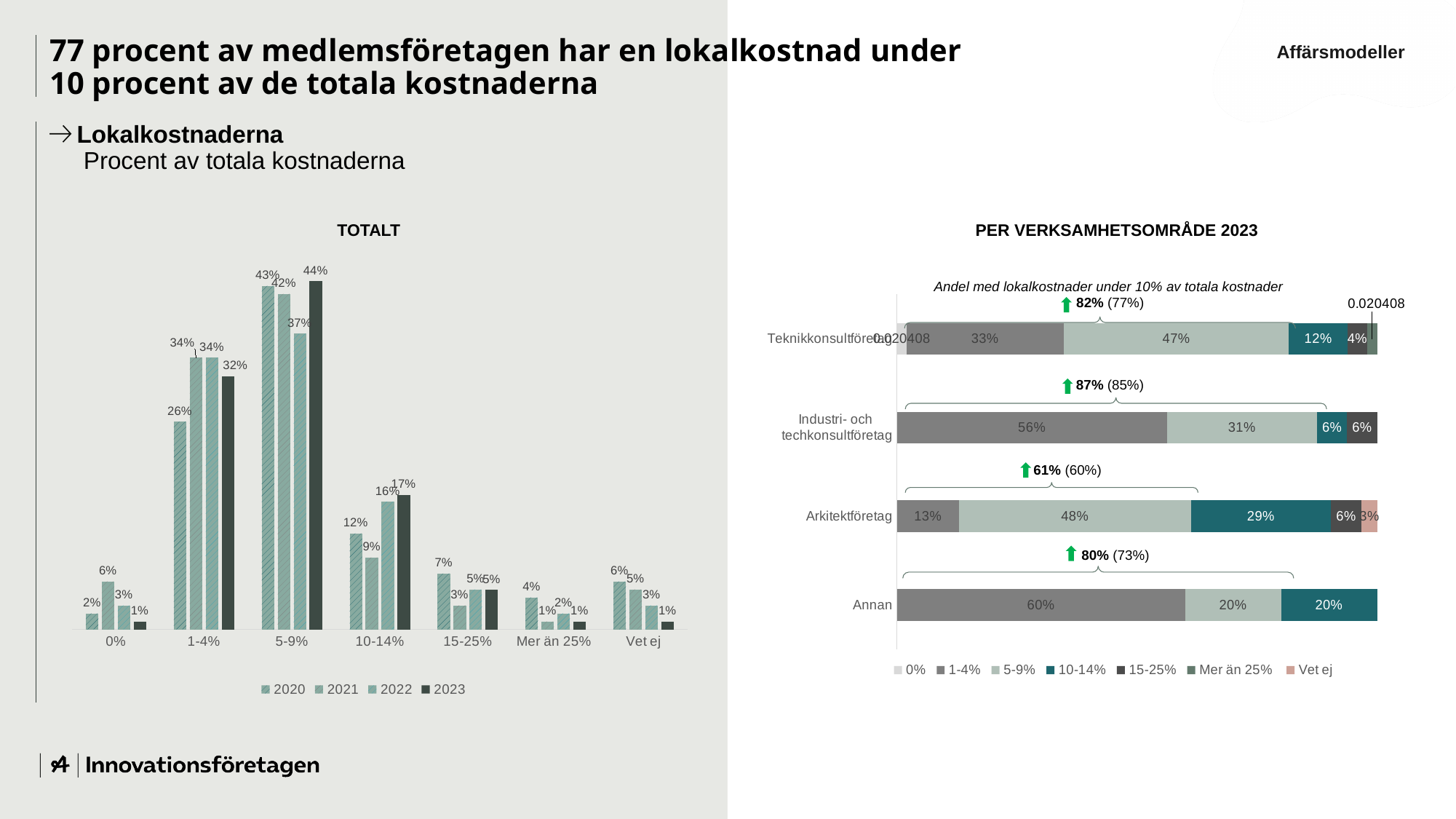
In the TOTALT chart, which category has the highest value for 2023? 5-9% In the PER VERKSAMHETSOMRÅDE 2023 chart, which category has the highest 1-4% value? Annan In the PER VERKSAMHETSOMRÅDE 2023 chart, what is the 5-9% value for Arkitektföretag? 48% In the TOTALT chart, what is the value for 2023 in the 5-9% category? 44% In the TOTALT chart, what is the difference between the 2023 and 2020 values in the 10-14% category? 5% How many series does the legend of the TOTALT chart list? 4 How many categories are shown on the x axis of the TOTALT chart? 7 In the PER VERKSAMHETSOMRÅDE 2023 chart, what is the 1-4% value for Annan? 60% In the TOTALT chart, what is the value for 2020 in the 1-4% category? 26% How many series does the legend of the PER VERKSAMHETSOMRÅDE 2023 chart list? 7 What kind of chart is the TOTALT chart? Bar chart In the TOTALT chart, which is larger in the 0% category: the 2021 value or the 2022 value? 2021